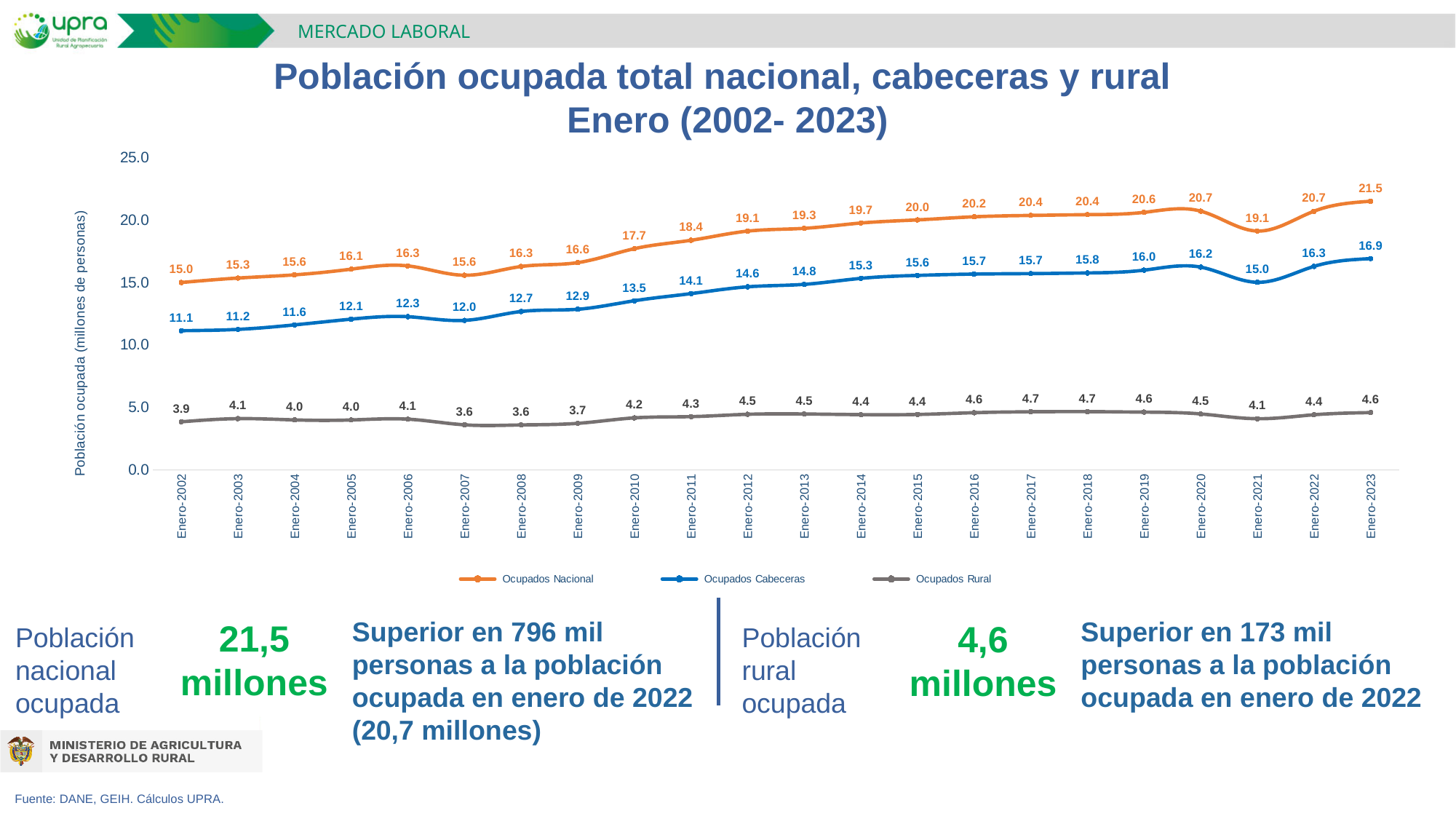
How many series does the legend list? 3 In which year does Ocupados Nacional reach its highest value? Enero-2023 What is the difference between Ocupados Nacional in Enero-2023 and Enero-2022? 0.8 What kind of chart is shown on the slide? line chart What is the value for Ocupados Rural in Enero-2007? 3.6 In which year is Ocupados Cabeceras at its lowest value? Enero-2002 Which colour represents Ocupados Cabeceras in the chart? blue What is the value for Ocupados Cabeceras in Enero-2012? 14.6 What is the value for Ocupados Nacional in Enero-2023? 21.5 Which is larger: Ocupados Rural in Enero-2017 or in Enero-2021? Enero-2017 How many years are shown on the x axis? 22 Is the value for Ocupados Cabeceras in Enero-2021 greater or less than 10.0? greater